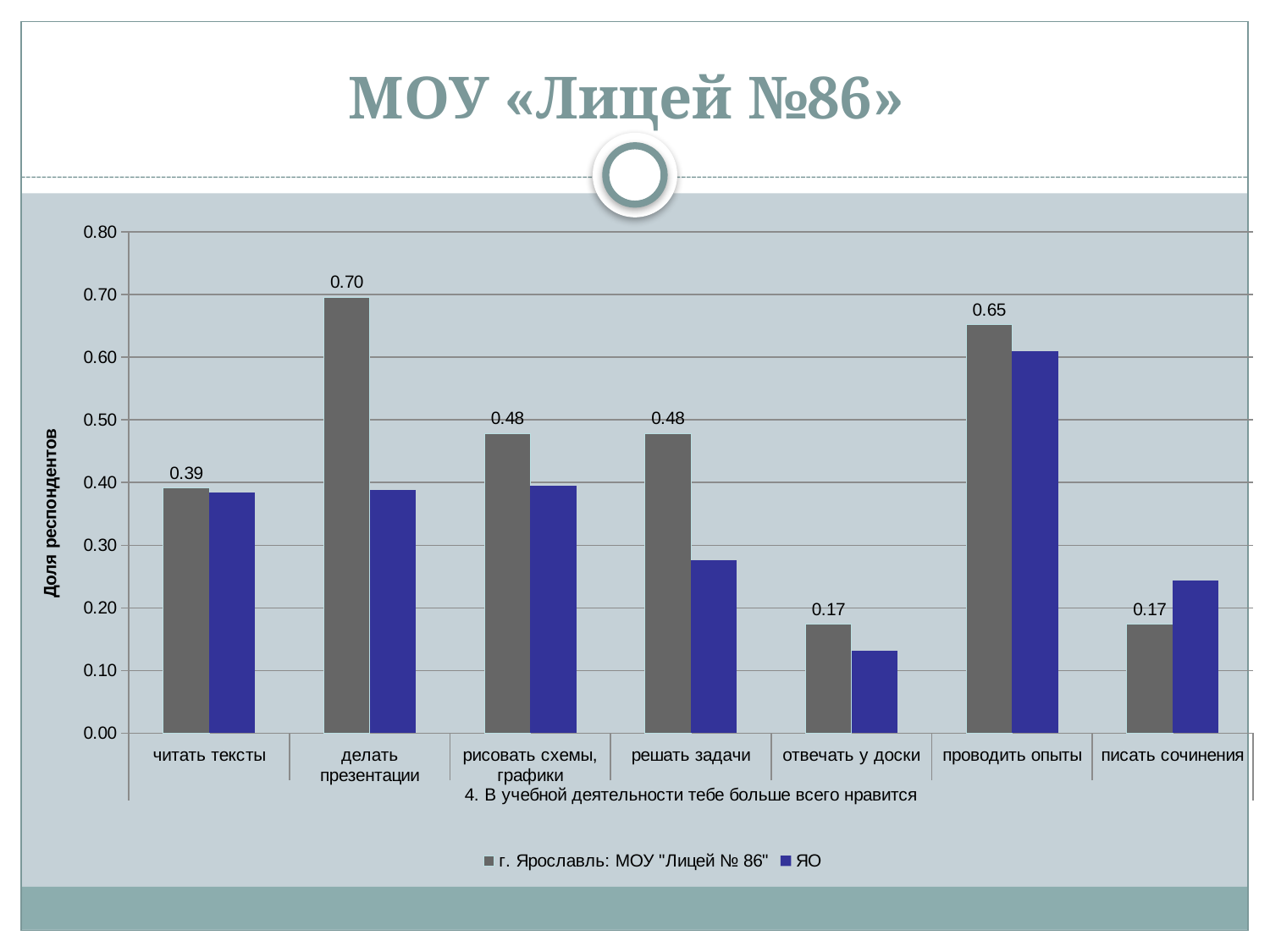
Which category has the highest value in the series ЯО? проводить опыты What is the value for "делать презентации" in the series г. Ярославль: МОУ "Лицей № 86"? 0.70 What is the value for "читать тексты" in the series г. Ярославль: МОУ "Лицей № 86"? 0.39 For "писать сочинения", which series has the larger value: г. Ярославль: МОУ "Лицей № 86" or ЯО? ЯО What is the value for "проводить опыты" in the series г. Ярославль: МОУ "Лицей № 86"? 0.65 What is the difference between the values for "делать презентации" and "проводить опыты" in the series г. Ярославль: МОУ "Лицей № 86"? 0.05 For "решать задачи", which series has the larger value: г. Ярославль: МОУ "Лицей № 86" or ЯО? г. Ярославль: МОУ "Лицей № 86" How many series does the legend list? 2 Which category has the highest value in the series г. Ярославль: МОУ "Лицей № 86"? делать презентации How many categories are shown on the x axis of the chart? 7 Is the value for "проводить опыты" in the series ЯО greater or less than 0.50? greater Is the value for "решать задачи" in the series ЯО greater or less than 0.30? less